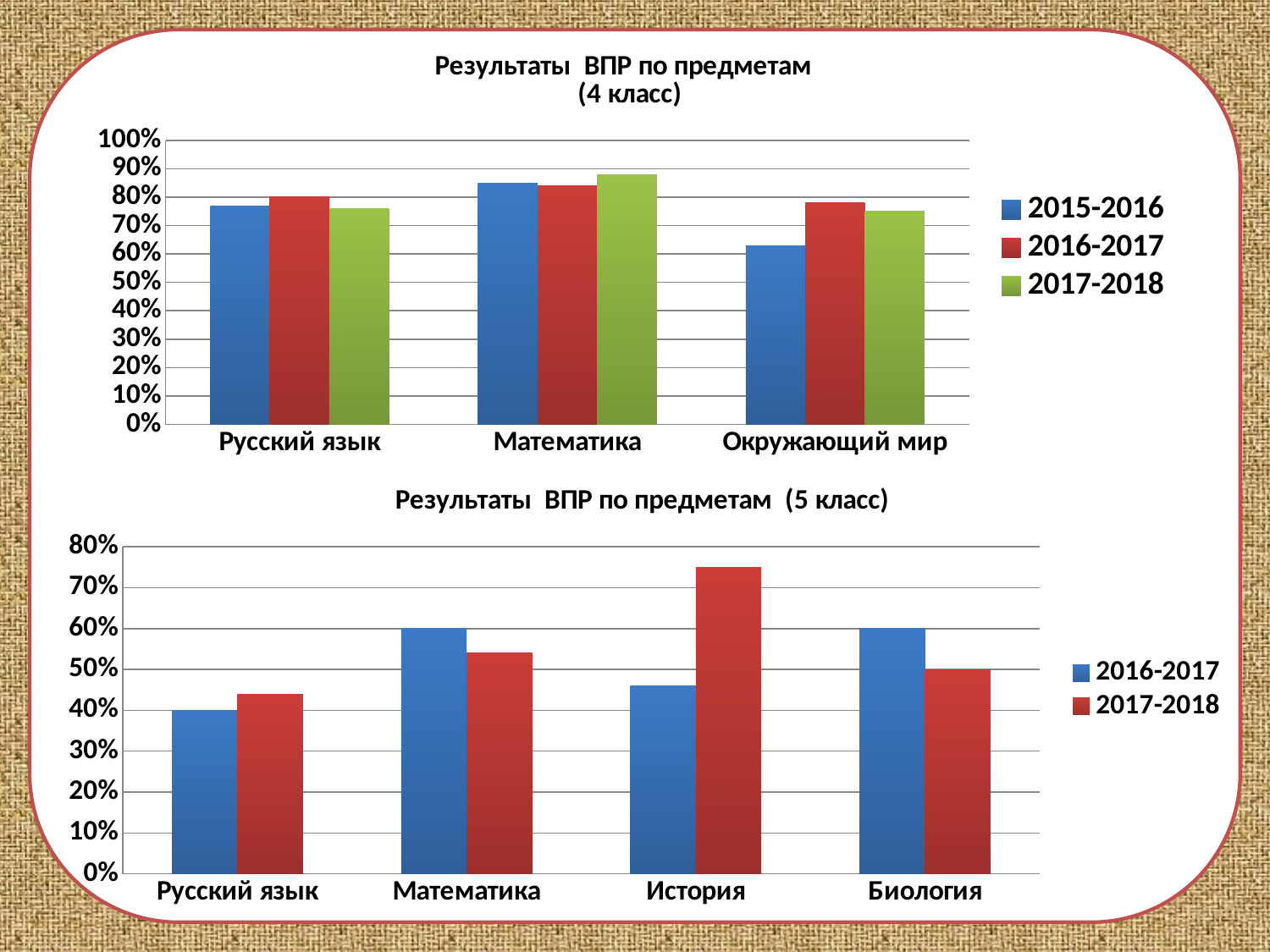
In the top chart (4 класс), which is larger for Математика: the 2015-2016 value or the 2017-2018 value? 2017-2018 In the bottom chart (5 класс), what is the value for Русский язык in 2016-2017? 40% In the bottom chart (5 класс), is the value for История in 2017-2018 greater or less than 70%? greater In the bottom chart (5 класс), which subject has the lowest value for 2016-2017? Русский язык In the bottom chart (5 класс), what is the value for Биология in 2017-2018? 50% In the bottom chart (5 класс), what is the value for Математика in 2016-2017? 60% What kind of chart is the top chart, 'Результаты ВПР по предметам (4 класс)'? bar chart How many series does the legend of the top chart (4 класс) list? 3 In the top chart (4 класс), is the value for Окружающий мир in 2015-2016 greater or less than 70%? less How many subject categories are shown on the x axis of the bottom chart (5 класс)? 4 In the top chart (4 класс), which subject has the lowest value for 2015-2016? Окружающий мир In the bottom chart (5 класс), which subject has the highest value for 2017-2018? История